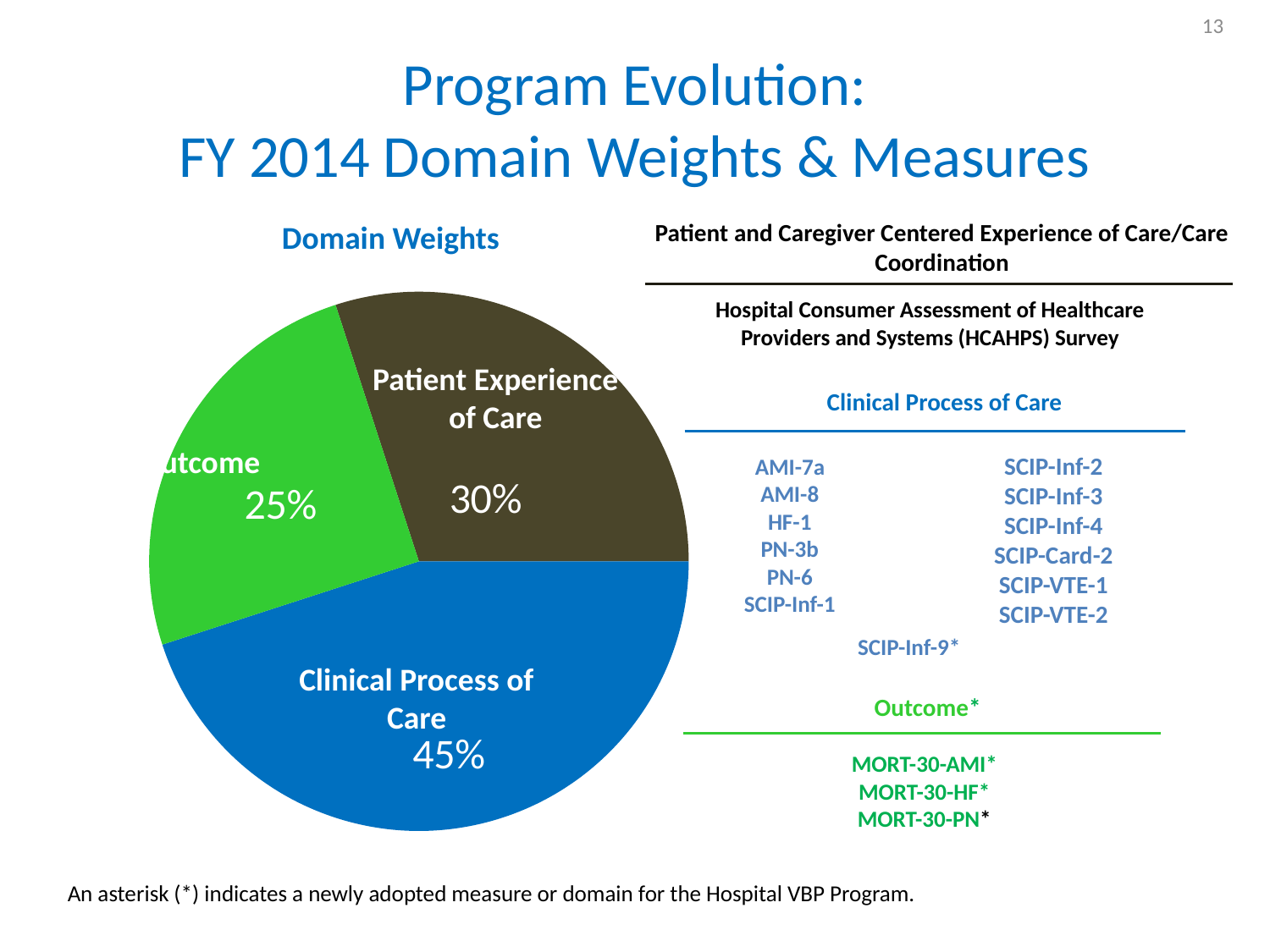
Which domain has the smallest slice in the Domain Weights pie chart? Outcome What is the weight shown for the Outcome domain in the Domain Weights pie chart? 25% In the Domain Weights pie chart, what is the difference between the Clinical Process of Care weight and the Patient Experience of Care weight? 15% What is the weight shown for Patient Experience of Care in the Domain Weights pie chart? 30% What kind of chart is shown under the title "Domain Weights"? pie chart In the Domain Weights pie chart, what is the difference between the Patient Experience of Care weight and the Outcome weight? 5% How many slices does the Domain Weights pie chart have? 3 What colour is the Clinical Process of Care slice in the Domain Weights pie chart? blue In the Domain Weights pie chart, which is larger: the Outcome slice or the Patient Experience of Care slice? Patient Experience of Care Which domain has the largest slice in the Domain Weights pie chart? Clinical Process of Care What is the title of the pie chart on the slide? Domain Weights What is the weight shown for Clinical Process of Care in the Domain Weights pie chart? 45%